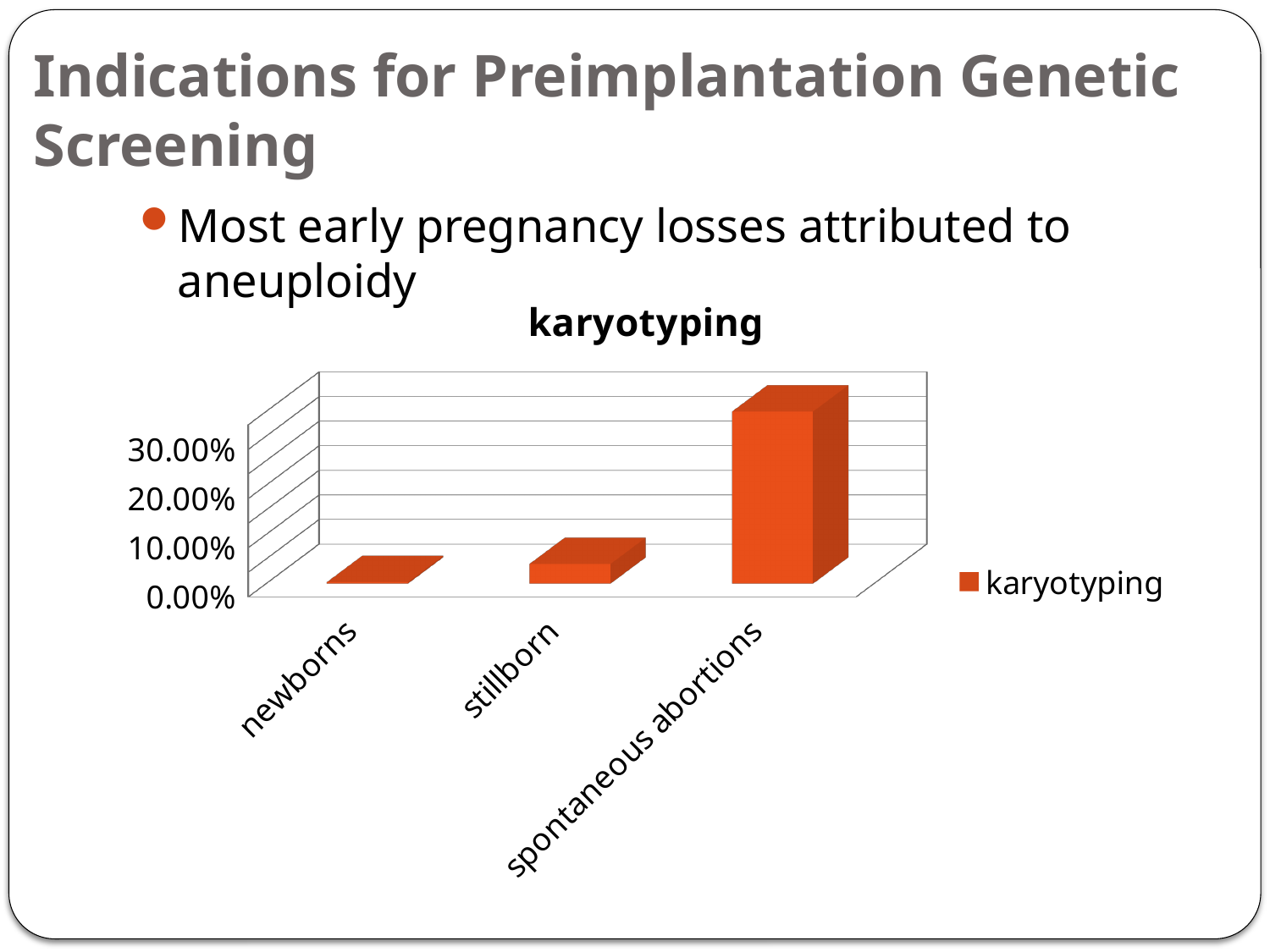
Which has a larger value, stillborn or newborns? stillborn Which category has the lowest value in the chart? newborns Is the value for spontaneous abortions greater or less than 30.00%? greater Is the value for stillborn greater or less than 10.00%? less What kind of chart is shown on the slide? bar chart How many categories are shown on the x axis of the chart? 3 Is the value for newborns greater or less than 10.00%? less Which has a larger value, stillborn or spontaneous abortions? spontaneous abortions How many series does the chart legend list? 1 What is the title of the chart? karyotyping Which category has the highest value in the chart? spontaneous abortions What is the name of the series shown in the chart legend? karyotyping